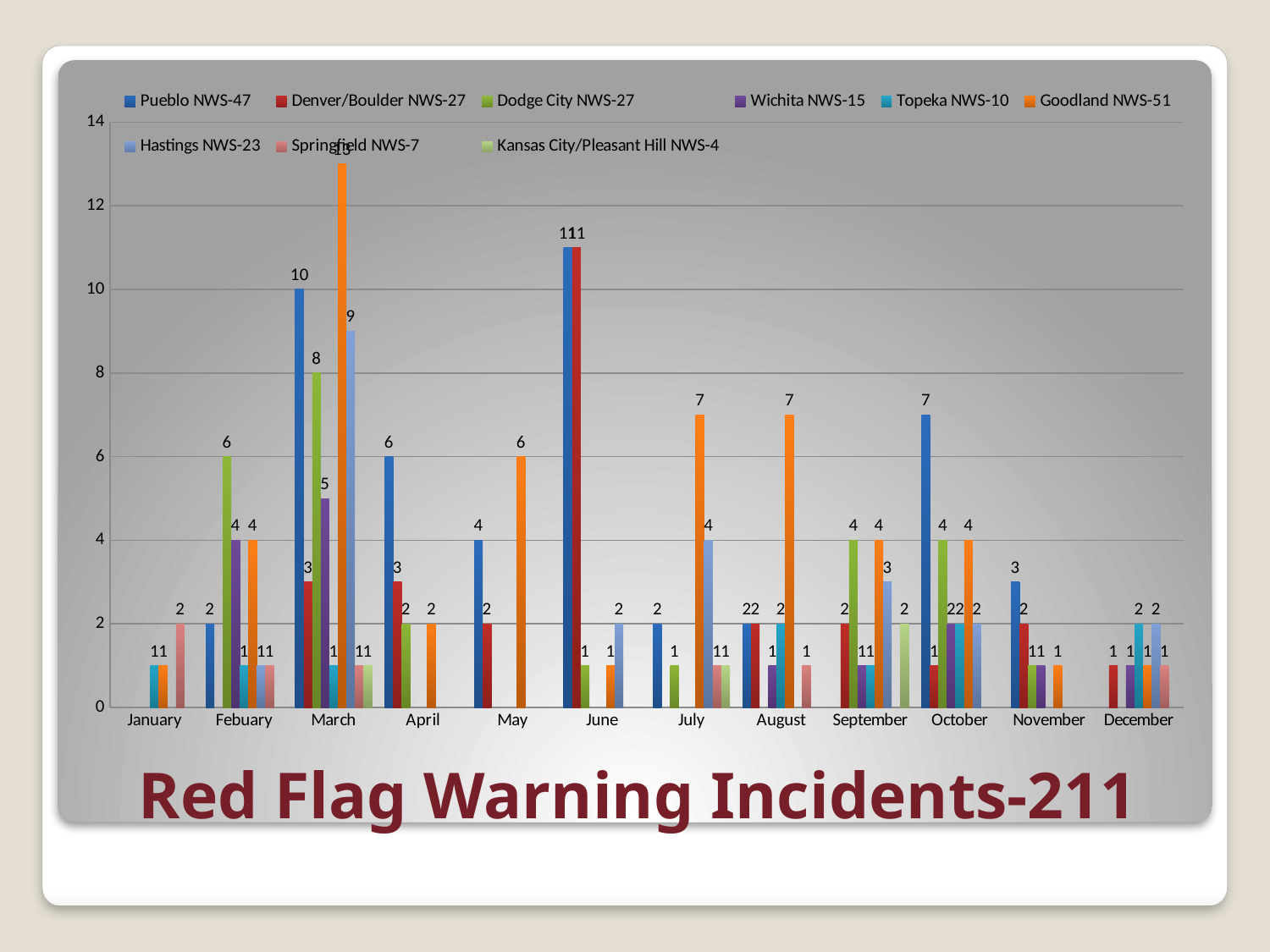
How many series does the legend list? 9 What is the value for Pueblo NWS-47 in October? 7 In which month does Pueblo NWS-47 have its highest value? June What is the value for Pueblo NWS-47 in June? 11 What is the value for Goodland NWS-51 in March? 13 What kind of chart is shown on the slide? Bar chart How many months are shown on the x axis? 12 In which month does Goodland NWS-51 have its highest value? March Is the value for Goodland NWS-51 in March greater or less than 12? greater What is the value for Hastings NWS-23 in March? 9 Which is larger in February: Dodge City NWS-27 or Wichita NWS-15? Dodge City NWS-27 What is the difference between the Pueblo NWS-47 value in June and its value in March? 1